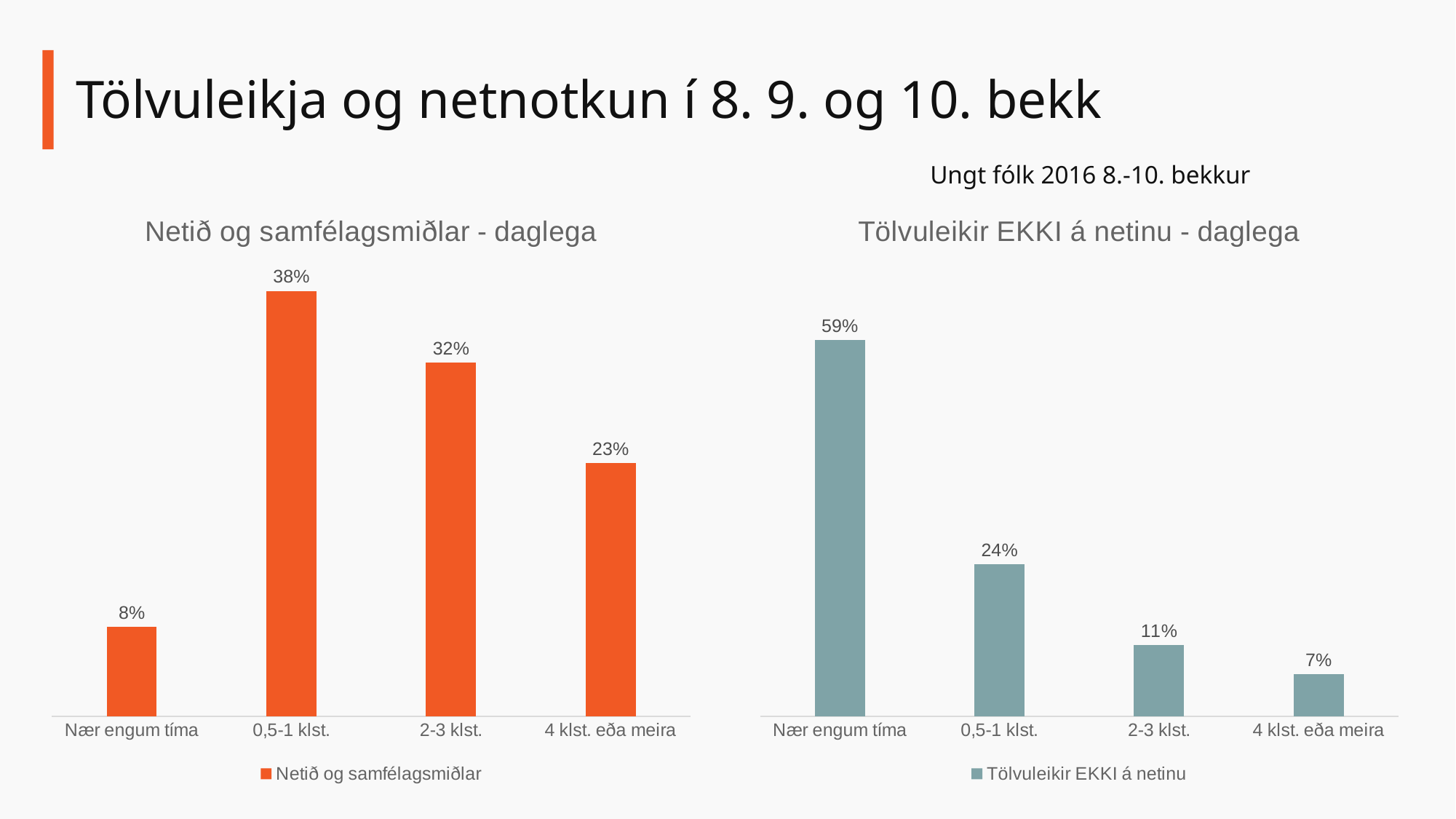
In the chart titled "Netið og samfélagsmiðlar - daglega", what is the difference between the values for "0,5-1 klst." and "4 klst. eða meira"? 15% How many series does the legend of the chart titled "Netið og samfélagsmiðlar - daglega" list? 1 How many categories are shown in the chart titled "Netið og samfélagsmiðlar - daglega"? 4 What is the legend entry of the chart on the right side of the slide? Tölvuleikir EKKI á netinu In the chart titled "Tölvuleikir EKKI á netinu - daglega", which category has the highest value? Nær engum tíma In the chart titled "Tölvuleikir EKKI á netinu - daglega", what is the difference between the values for "Nær engum tíma" and "0,5-1 klst."? 35% In the chart titled "Tölvuleikir EKKI á netinu - daglega", what is the value for "Nær engum tíma"? 59% What kind of chart is the chart titled "Tölvuleikir EKKI á netinu - daglega"? Bar chart In the chart titled "Tölvuleikir EKKI á netinu - daglega", do the values rise or fall from left to right across the categories? Fall In the chart titled "Tölvuleikir EKKI á netinu - daglega", which is larger: the value for "2-3 klst." or "4 klst. eða meira"? 2-3 klst. In the chart titled "Netið og samfélagsmiðlar - daglega", which category has the lowest value? Nær engum tíma In the chart titled "Netið og samfélagsmiðlar - daglega", what is the value for "0,5-1 klst."? 38%